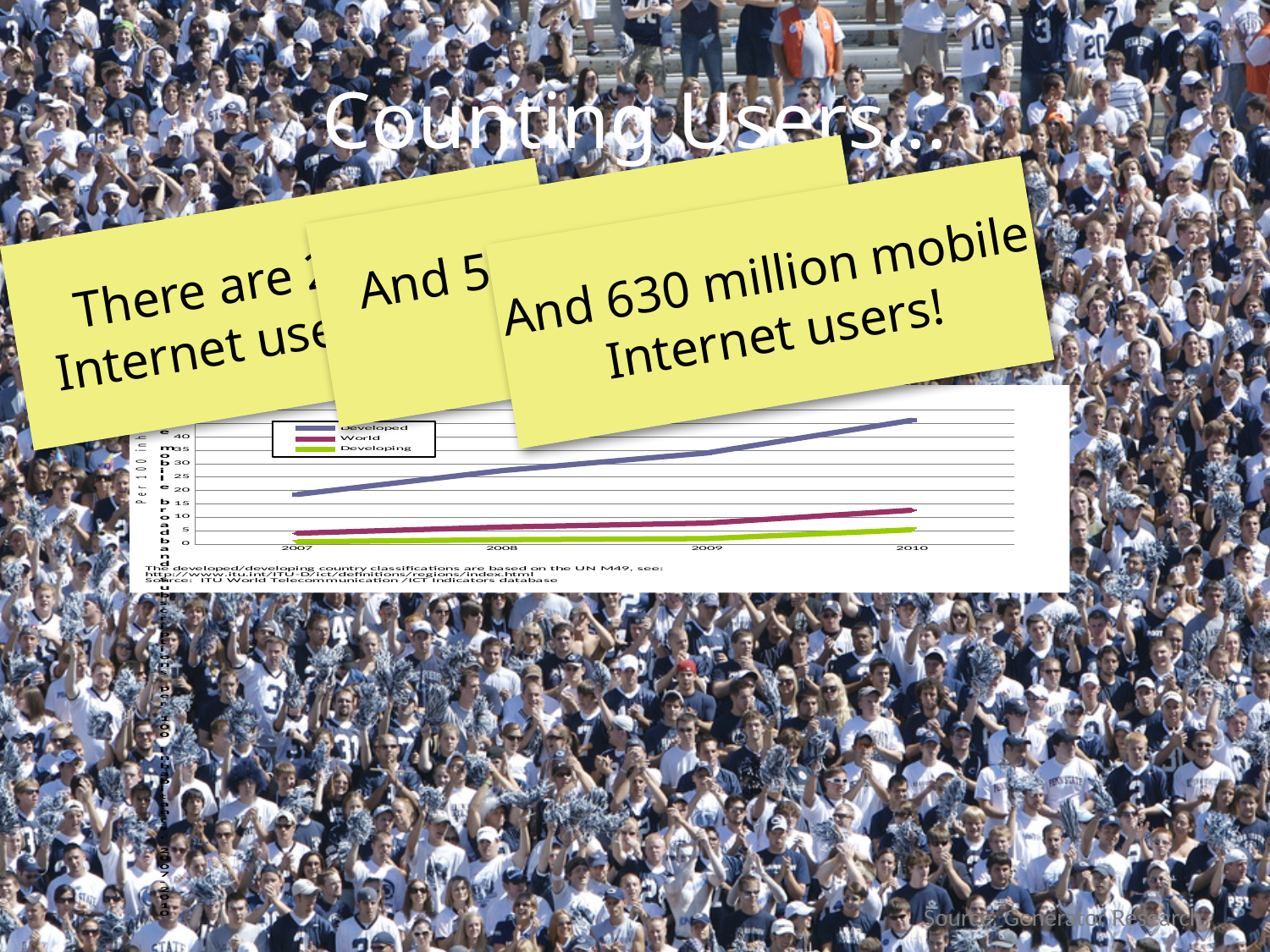
What kind of chart is shown on the slide? line chart What colour is the Developing line in the chart? green Is the value for Developing in 2007 greater or less than 5? less Is the value for Developed in 2010 greater or less than 40? greater How many series does the chart's legend list? 3 Which series has the lowest values throughout the chart? Developing Does the Developed line rise or fall from 2007 to 2010? rise Which series has the highest values throughout the chart? Developed Is the value for World in 2010 greater or less than 10? greater Which is larger in 2010, the value for World or the value for Developing? World How many years are shown along the x axis of the chart? 4